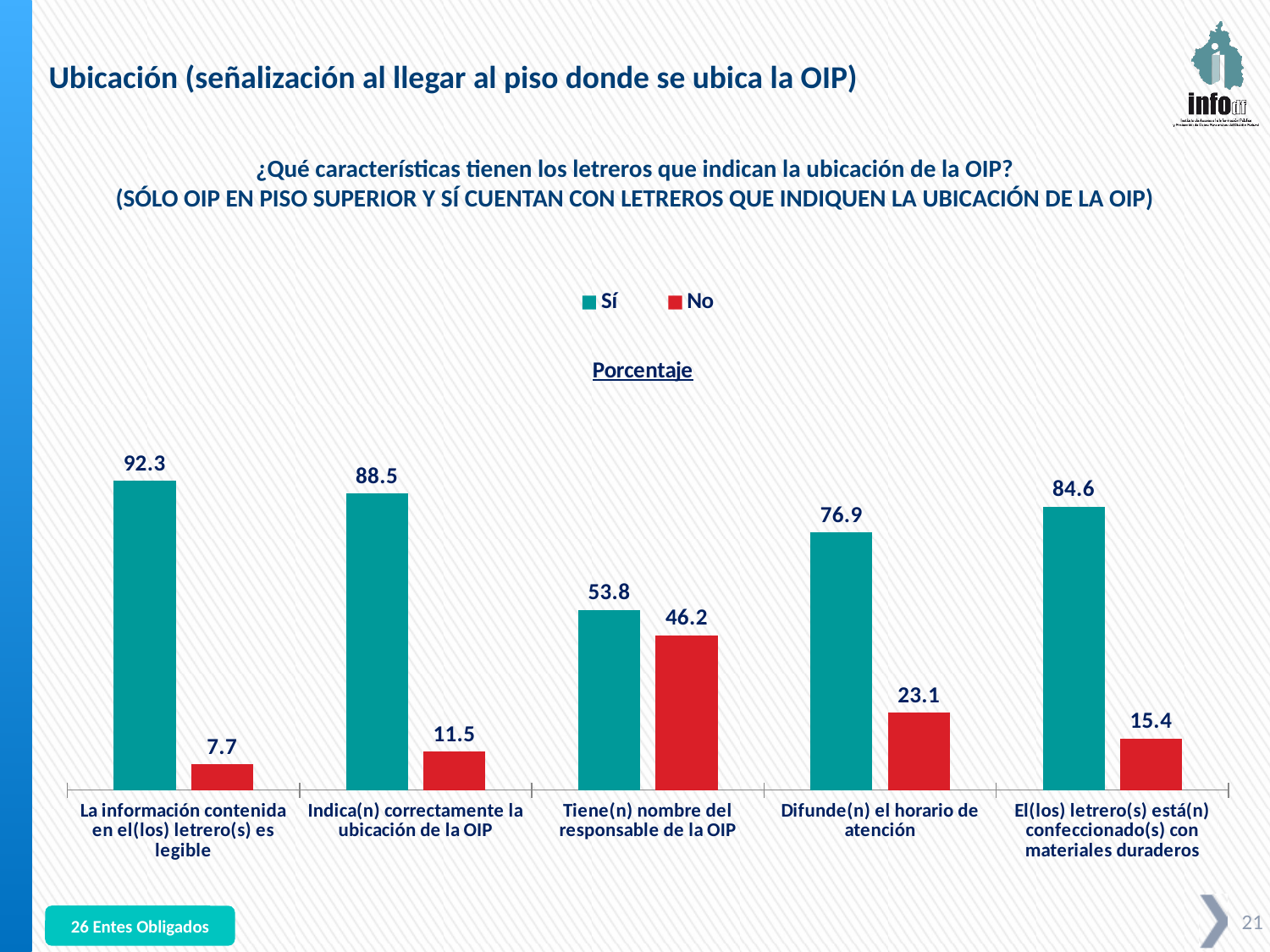
How many series does the legend list? 2 What is the 'No' value for 'Tiene(n) nombre del responsable de la OIP'? 46.2 Which category has the highest 'Sí' value? La información contenida en el(los) letrero(s) es legible What is the 'Sí' value for 'Difunde(n) el horario de atención'? 76.9 Which is larger: the 'No' value for 'Difunde(n) el horario de atención' or the 'No' value for 'Indica(n) correctamente la ubicación de la OIP'? Difunde(n) el horario de atención How many categories are shown on the x axis? 5 What kind of chart is shown on the slide? Bar chart Which category has the lowest 'No' value? La información contenida en el(los) letrero(s) es legible What is the difference between the 'Sí' and 'No' values for 'Indica(n) correctamente la ubicación de la OIP'? 77.0 Which category has the lowest 'Sí' value? Tiene(n) nombre del responsable de la OIP What is the 'Sí' value for 'La información contenida en el(los) letrero(s) es legible'? 92.3 What is the 'No' value for 'El(los) letrero(s) está(n) confeccionado(s) con materiales duraderos'? 15.4